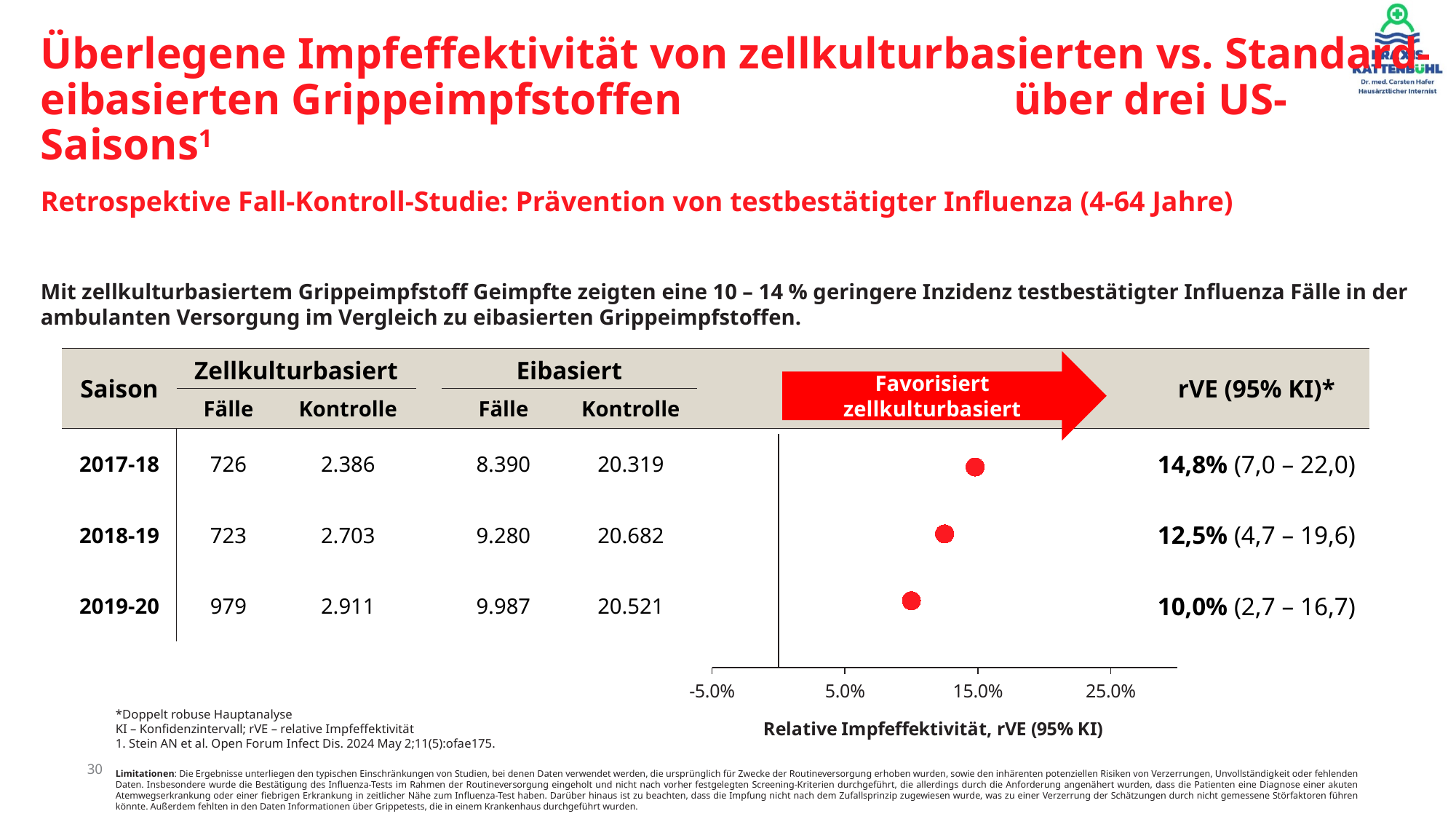
Which season has the highest rVE? 2017-18 How many seasons are plotted in the chart? 3 What is the rVE value for the 2018-19 season? 12,5% Which season has a larger rVE, 2018-19 or 2019-20? 2018-19 What is the title of the horizontal axis of the chart? Relative Impfeffektivität, rVE (95% KI) Is the rVE value for 2019-20 greater or less than 15.0%? less What does the red arrow above the chart say? Favorisiert zellkulturbasiert What is the rVE value for the 2019-20 season? 10,0% What is the rVE value for the 2017-18 season? 14,8% Do the rVE values rise or fall from the 2017-18 season to the 2019-20 season? fall What is the difference in rVE between the 2017-18 and 2019-20 seasons? 4,8 percentage points Which season has the lowest rVE? 2019-20